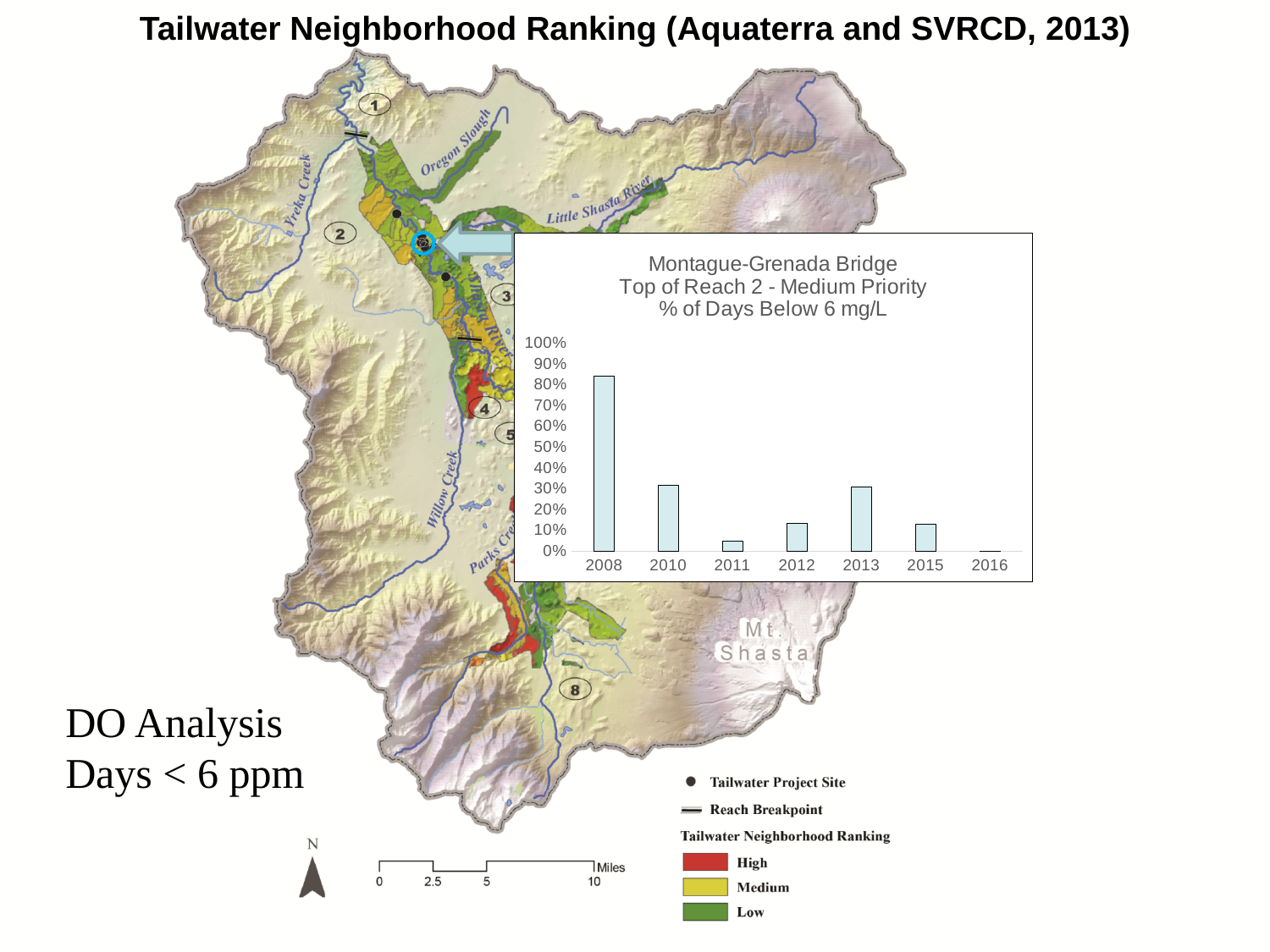
What is the title of the chart? Montague-Grenada Bridge Top of Reach 2 - Medium Priority % of Days Below 6 mg/L Which year has the highest % of days below 6 mg/L? 2008 Is the value for 2013 greater or less than 20%? greater What kind of chart is shown on the slide? bar chart Is the value for 2010 greater or less than 20%? greater Is the value for 2012 greater or less than 20%? less How many years are shown on the x axis of the chart? 7 Which year has the lowest % of days below 6 mg/L? 2016 Which year has a larger value, 2011 or 2012? 2012 Which year has a larger value, 2008 or 2010? 2008